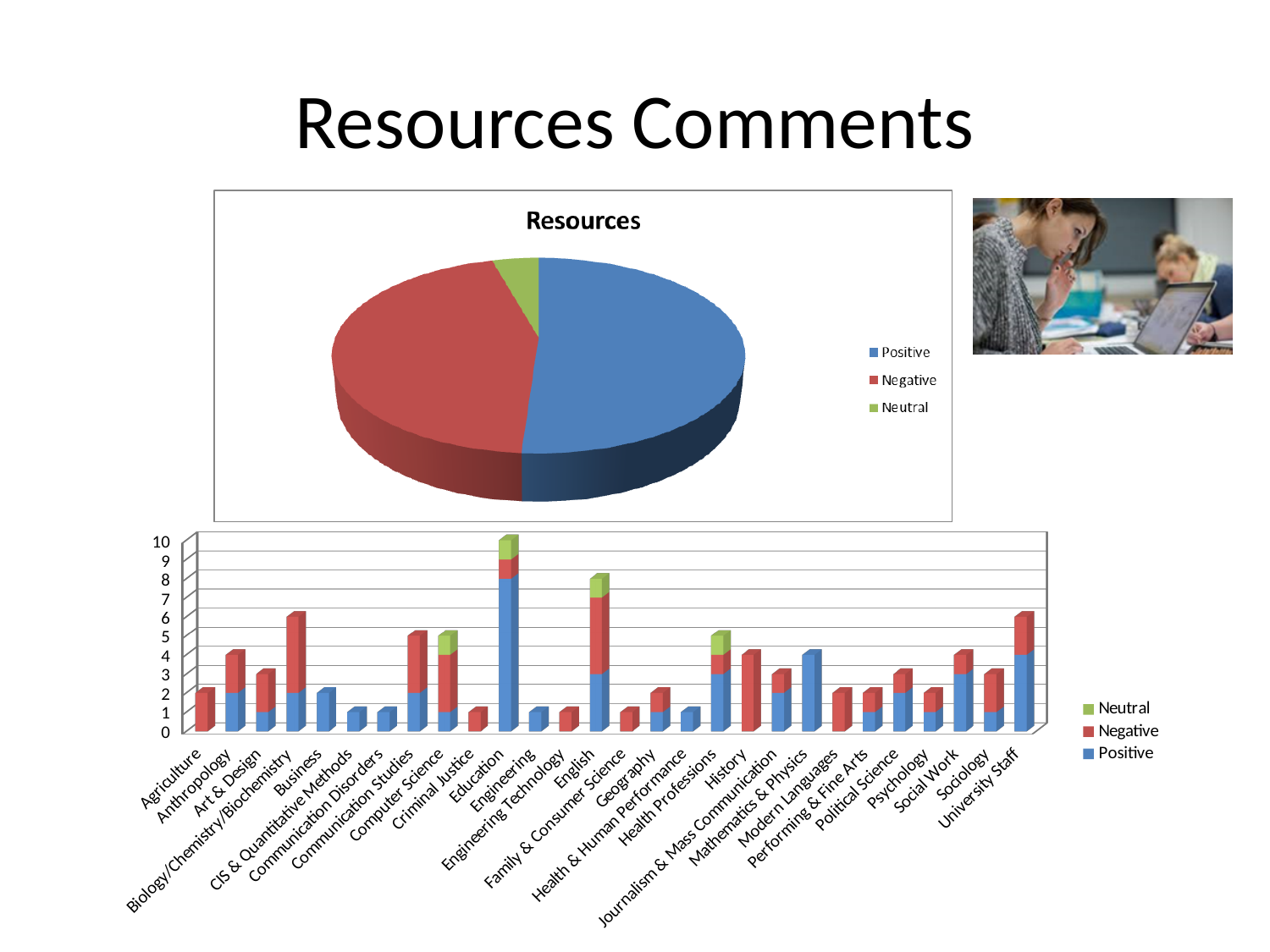
In the bottom bar chart, which has the taller stacked bar, English or Geography? English In the "Resources" pie chart, which category has the smallest slice? Neutral In the bottom bar chart, which has the taller stacked bar, Biology/Chemistry/Biochemistry or Business? Biology/Chemistry/Biochemistry In the bottom bar chart, is the total for Education greater or less than 8? greater In the "Resources" pie chart, which colour represents Negative? red In the "Resources" pie chart, how many series does the legend list? 3 In the bottom bar chart, what are the three legend entries? Neutral, Negative, Positive In the bottom bar chart, how many department categories are shown on the x axis? 28 What kind of chart is the chart at the bottom of the slide showing departments? bar chart In the bottom bar chart, which department has the tallest stacked bar? Education What kind of chart is the chart titled "Resources" at the top of the slide? pie chart In the bottom bar chart, is the total for Agriculture greater or less than 5? less